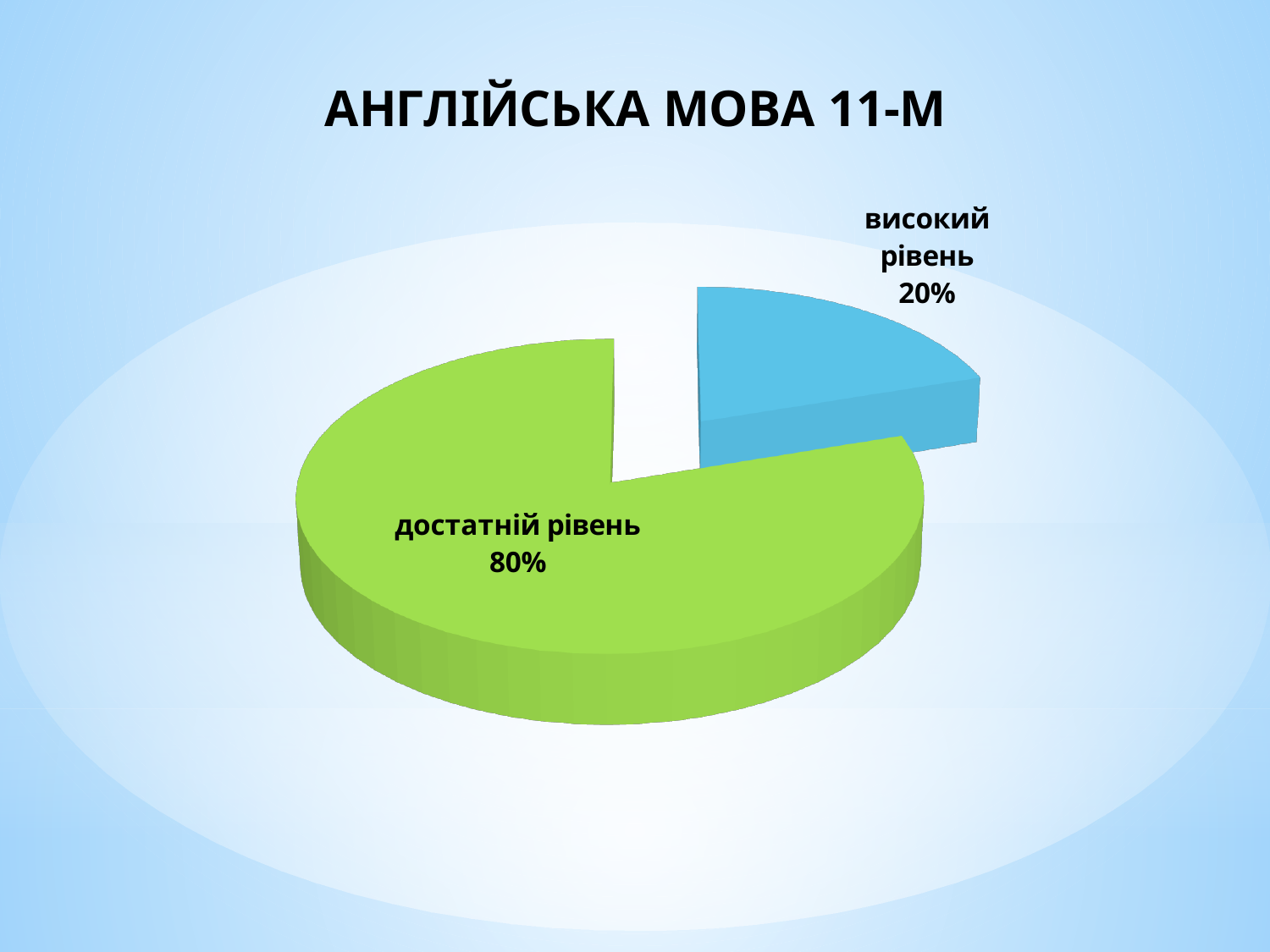
What kind of chart is shown on the slide? pie chart How many slices does the pie chart have? 2 What colour is the slice for "високий рівень"? blue What is the difference in percentage points between "достатній рівень" and "високий рівень"? 60 What share of the pie does "високий рівень" have? 20% Which category has the smallest slice of the pie? високий рівень Which is larger: the slice for "достатній рівень" or the slice for "високий рівень"? достатній рівень What share of the pie does "достатній рівень" have? 80% Which category has the largest slice of the pie? достатній рівень What is the title of the slide above the chart? АНГЛІЙСЬКА МОВА 11-М